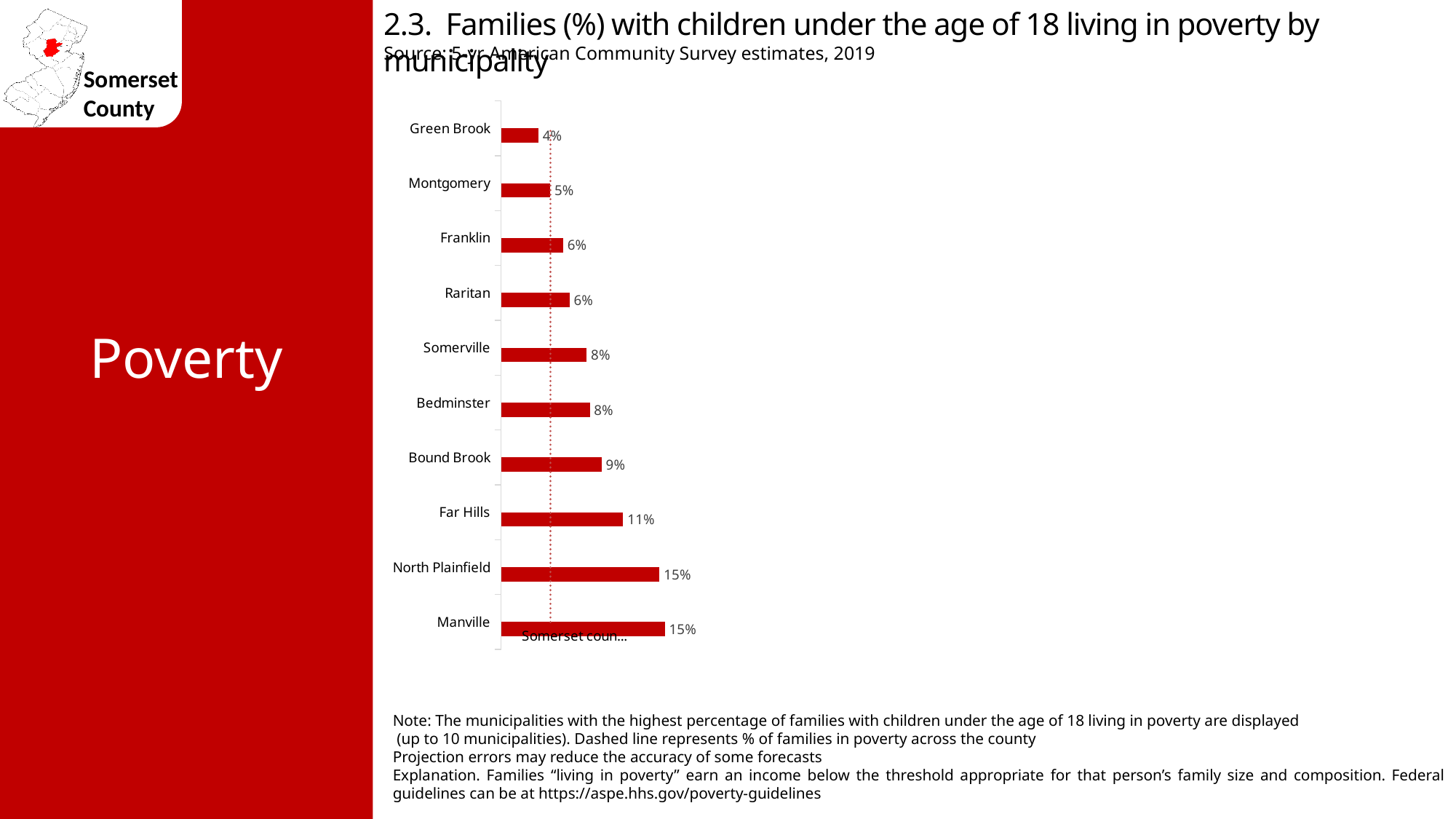
Which municipality has the lowest value? Green Brook What is the value for North Plainfield? 15% What is the value for Green Brook? 4% What is the difference between the values for Far Hills and Montgomery? 6% Which is larger, the value for Bedminster or the value for Far Hills? Far Hills What is the value for Far Hills? 11% What kind of chart is shown on the slide? Bar chart What is the value for Bound Brook? 9% Which is larger, the value for Bound Brook or the value for Franklin? Bound Brook How many municipalities are shown in the chart? 10 What does the dashed vertical line in the chart represent? % of families in poverty across the county What is the difference between the values for Manville and Somerville? 7%